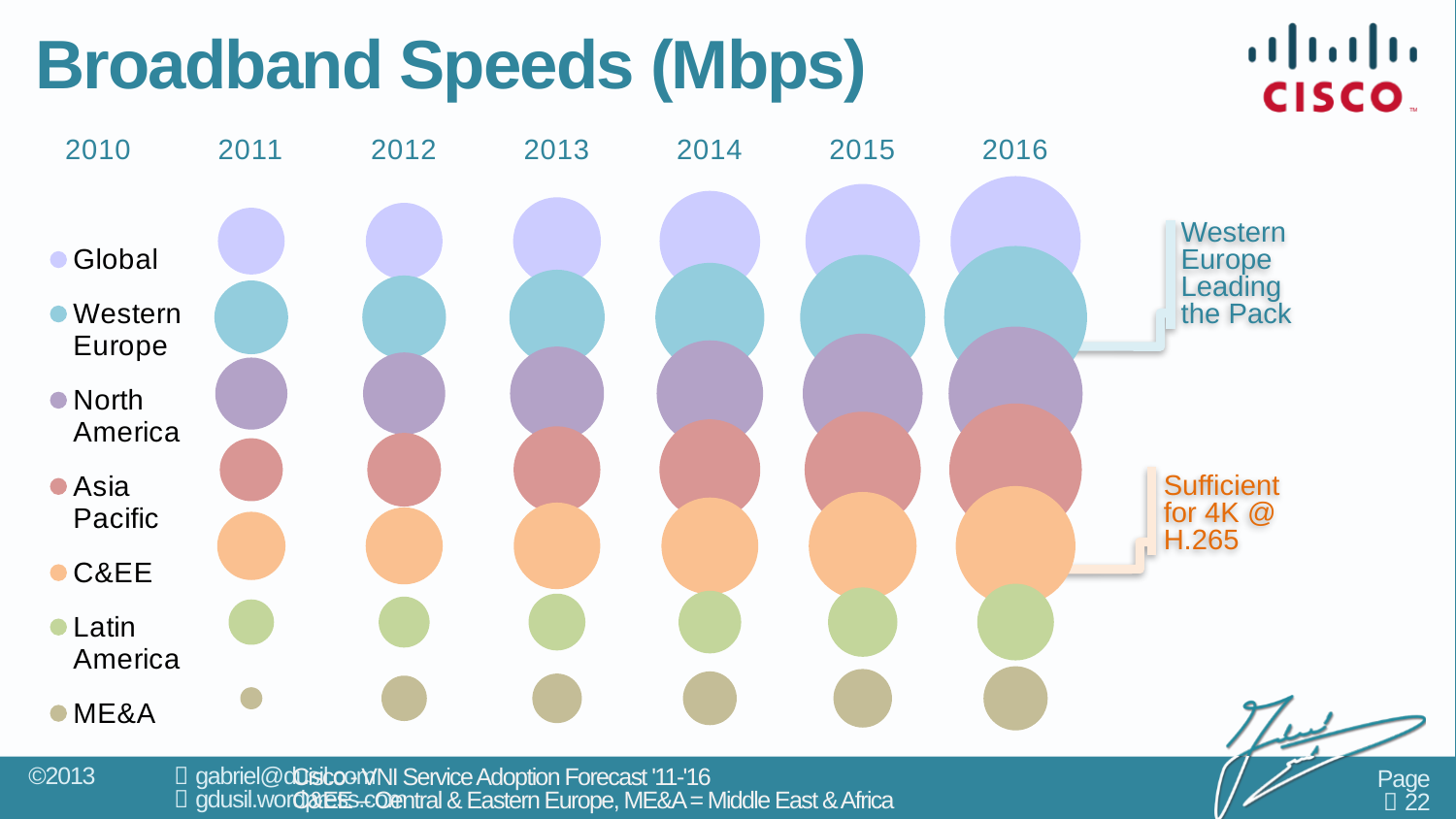
Do the bubble sizes for Western Europe rise or fall from 2011 to 2016? Rise What is the title of the chart? Broadband Speeds (Mbps) How many years are labelled along the top of the chart? 7 Do the bubble sizes for ME&A rise or fall from 2011 to 2016? Rise Which region has the smallest bubble in 2011? ME&A Which region does the annotation 'Leading the Pack' refer to? Western Europe How many regions (series) are listed down the left side of the chart? 7 Which region has the largest bubble in 2016? Western Europe What kind of chart is shown on the slide? Bubble chart In 2016, which is larger: the bubble for Western Europe or the bubble for ME&A? Western Europe Which region is listed last (at the bottom) in the chart's legend? ME&A In 2016, which is larger: the bubble for Asia Pacific or the bubble for Latin America? Asia Pacific